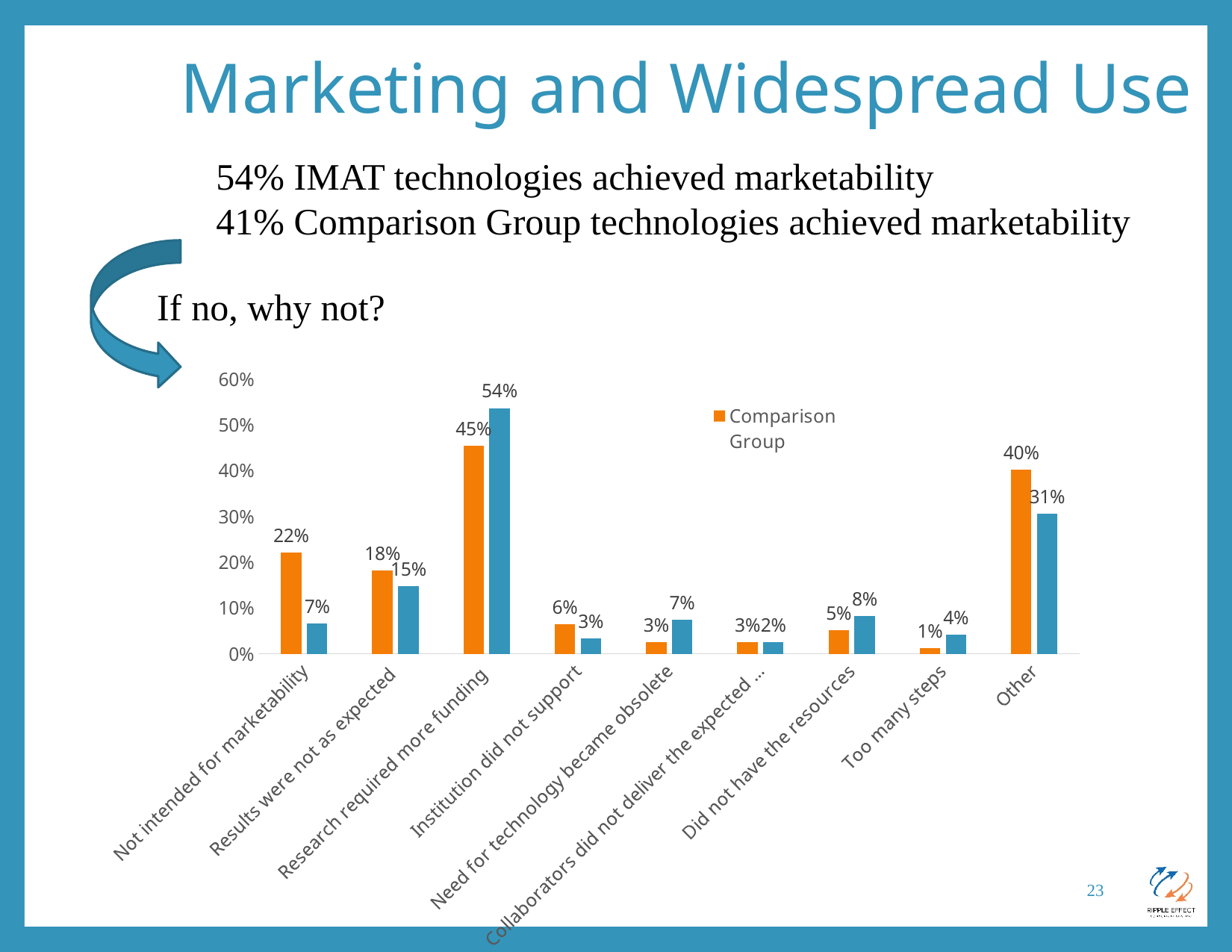
How many categories are shown on the x axis of the chart? 9 For "Other", which is larger: the Comparison Group bar or the blue bar? Comparison Group Which category has the highest Comparison Group value? Research required more funding What is the value of the blue bar for "Not intended for marketability"? 7% How many series does the chart's legend list? 1 What is the Comparison Group value for "Other"? 40% What type of chart is shown on the slide? Bar chart What is the value of the blue bar for "Too many steps"? 4% What is the Comparison Group value for "Research required more funding"? 45% Which category has the lowest Comparison Group value? Too many steps Is the Comparison Group value for "Not intended for marketability" greater or less than 20%? greater What is the difference between the blue bar and the Comparison Group bar for "Research required more funding"? 9%